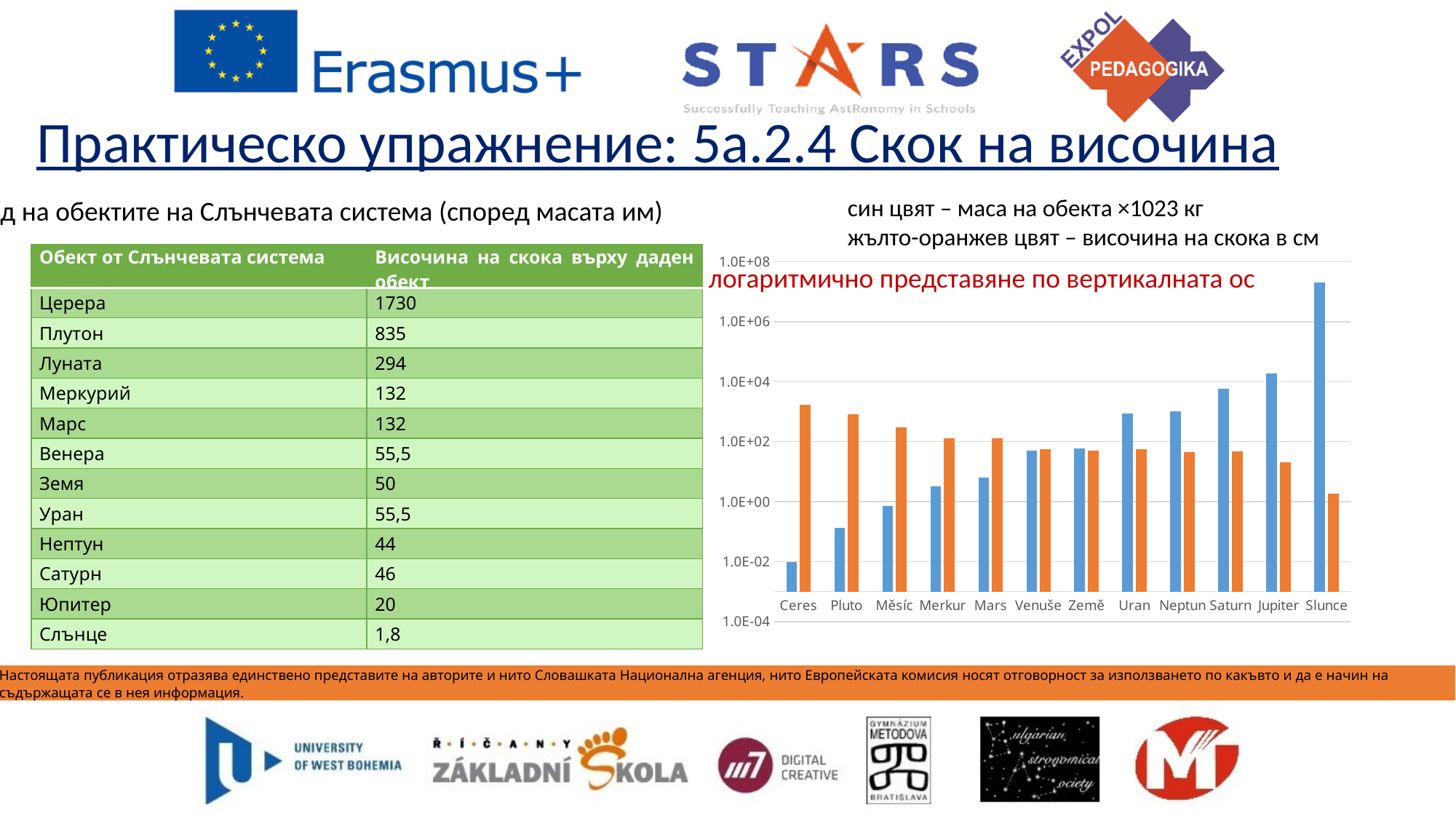
Is the blue bar for Slunce greater or less than 1.0E+06? greater Which category has the tallest orange bar in the chart? Ceres How many categories (objects) are shown on the x axis of the chart? 12 Which is larger, the blue bar for Slunce or the blue bar for Jupiter? Slunce Which category has the shortest blue bar in the chart? Ceres Which category has the tallest blue bar in the chart? Slunce According to the text above the chart, what does the blue colour represent? маса на обекта ×1023 кг Do the blue bars generally rise or fall from left to right along the x axis? rise What kind of chart is shown on the slide? bar chart Is the blue bar for Pluto greater or less than 1.0E+00? less Which category has the shortest orange bar in the chart? Slunce Is the orange bar for Ceres greater or less than 1.0E+02? greater